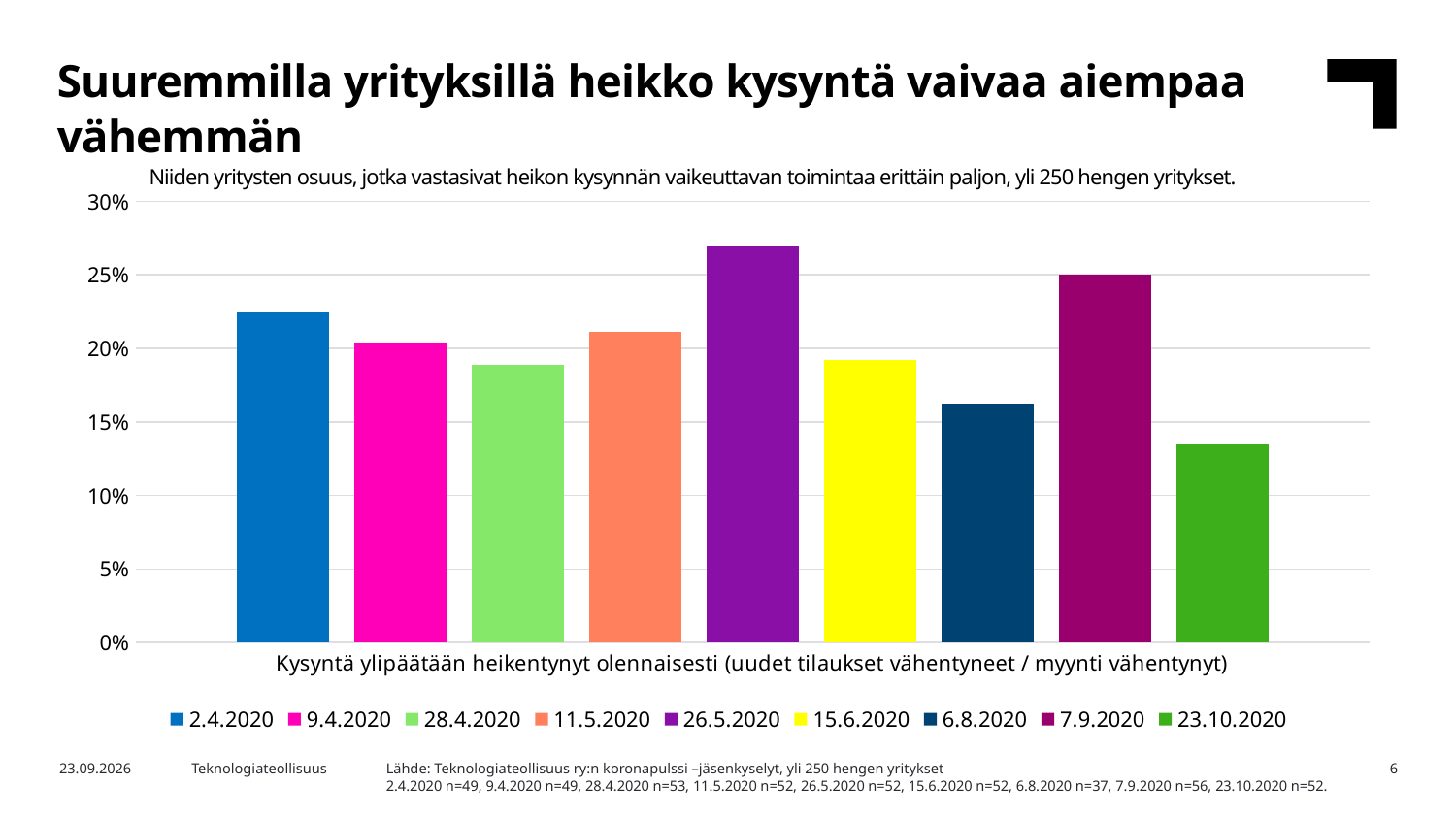
Which series has the lowest value? 23.10.2020 What is the category label shown on the x axis? Kysyntä ylipäätään heikentynyt olennaisesti (uudet tilaukset vähentyneet / myynti vähentynyt) Is the value for 6.8.2020 greater or less than 15%? greater Which is larger, the value for 2.4.2020 or the value for 9.4.2020? 2.4.2020 Is the value for 2.4.2020 greater or less than 20%? greater Is the value for 23.10.2020 greater or less than 15%? less Which series has the highest value? 26.5.2020 What kind of chart is shown on the slide? bar chart Which is larger, the value for 7.9.2020 or the value for 23.10.2020? 7.9.2020 How many series does the legend list? 9